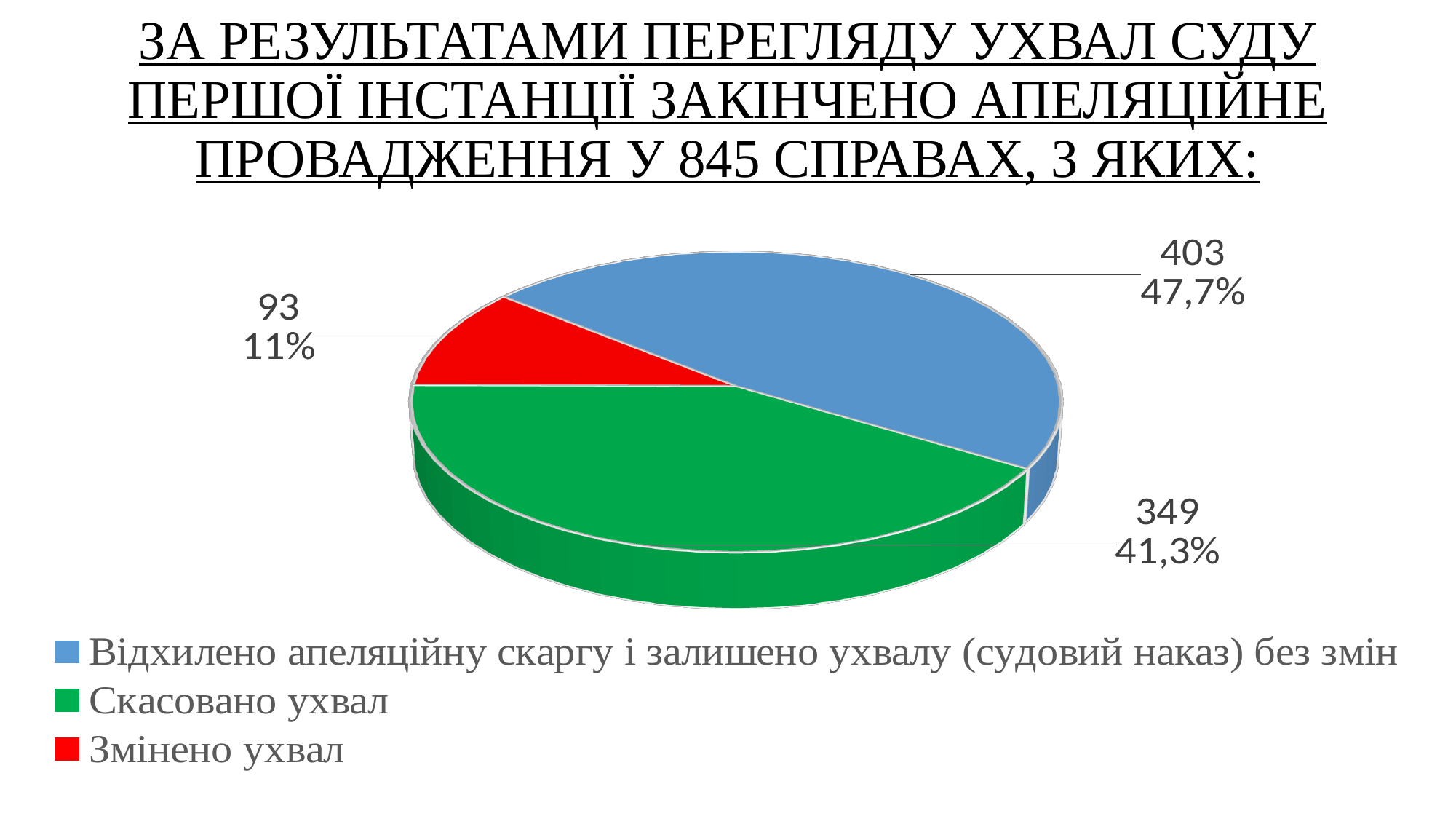
Which category has the largest slice? Відхилено апеляційну скаргу і залишено ухвалу (судовий наказ) без змін How many cases are in the "Відхилено апеляційну скаргу і залишено ухвалу (судовий наказ) без змін" slice? 403 What is the difference in cases between "Відхилено апеляційну скаргу і залишено ухвалу (судовий наказ) без змін" and "Скасовано ухвал"? 54 What share of the pie does "Змінено ухвал" represent? 11% How many cases are in the "Скасовано ухвал" slice? 349 What kind of chart is shown on the slide? pie chart Which category has the smallest slice? Змінено ухвал What share of the pie does "Скасовано ухвал" represent? 41,3% Which colour represents "Змінено ухвал" in the pie chart? red How many cases are in the "Змінено ухвал" slice? 93 How many entries does the legend list? 3 How many slices does the pie chart have? 3